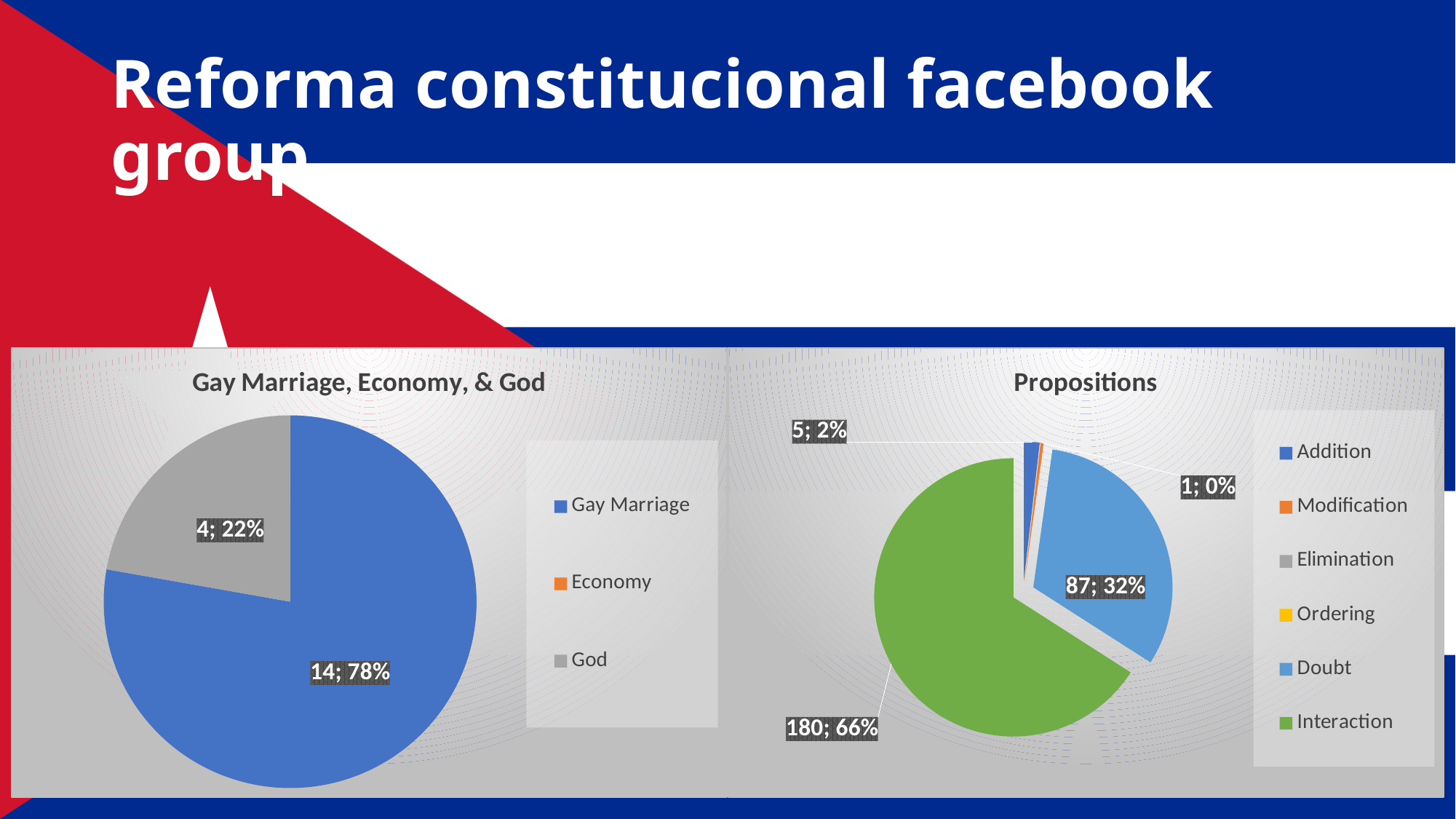
In the 'Gay Marriage, Economy, & God' chart, what is the difference between the Gay Marriage value and the God value? 10 In the 'Gay Marriage, Economy, & God' chart, what share of the pie does Gay Marriage represent? 78% In the 'Propositions' chart, which is larger, Doubt or Addition? Doubt In the 'Propositions' chart, what value is shown for Doubt? 87 In the 'Gay Marriage, Economy, & God' chart, what value is shown for Gay Marriage? 14 In the 'Propositions' chart, what is the difference between the Interaction value and the Doubt value? 93 In the 'Gay Marriage, Economy, & God' chart, which category has the largest slice? Gay Marriage In the 'Propositions' chart, what value is shown for Interaction? 180 In the 'Gay Marriage, Economy, & God' chart, what share of the pie does God represent? 22% What type of chart is the 'Propositions' chart? Pie chart How many entries does the legend of the 'Gay Marriage, Economy, & God' chart list? 3 In the 'Propositions' chart, what share of the pie does Interaction represent? 66%